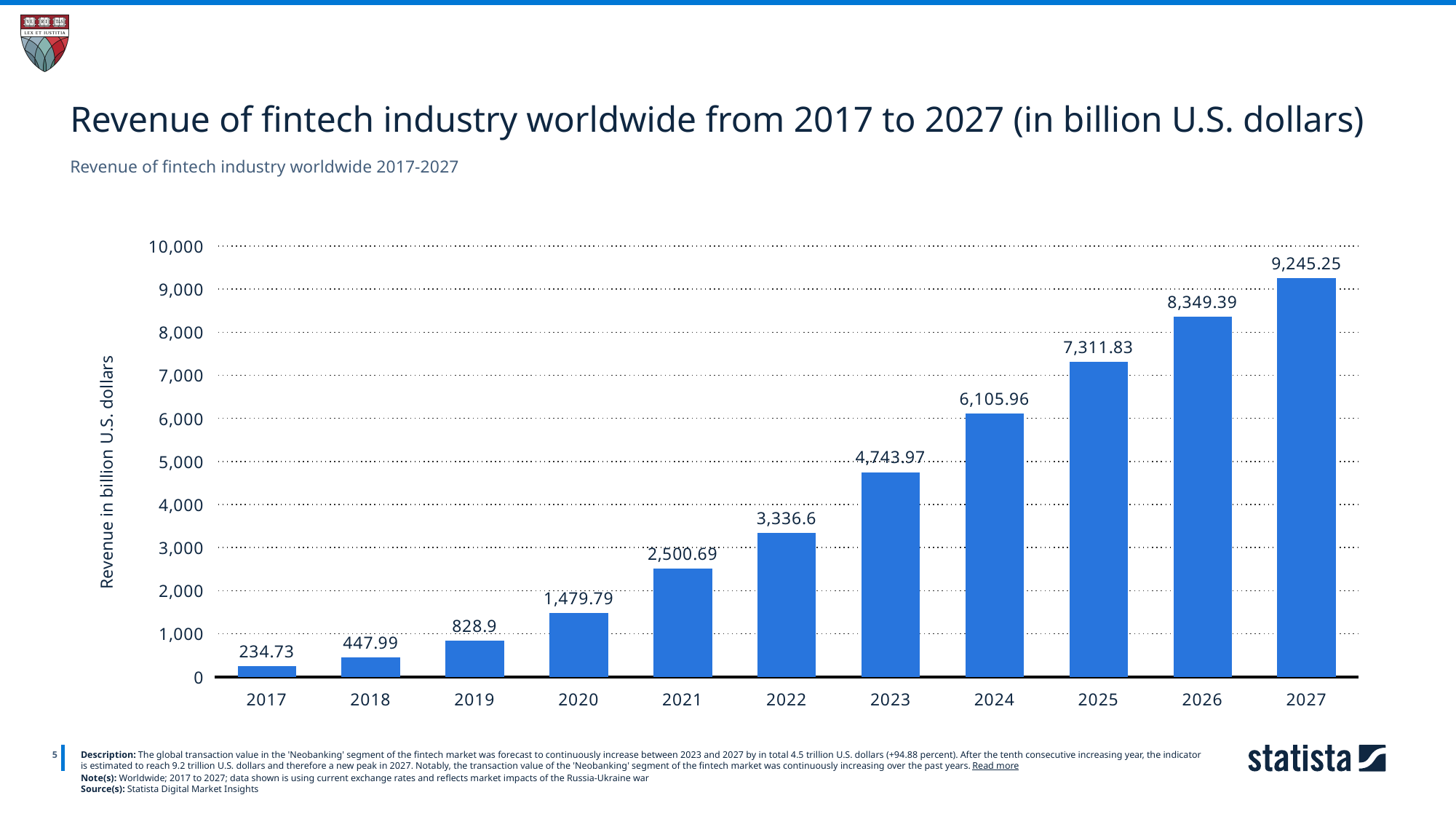
What is the revenue of the fintech industry worldwide in 2020? 1,479.79 Which is larger, the revenue in 2022 or the revenue in 2023? 2023 What is the difference between the revenue in 2018 and the revenue in 2017? 213.26 What is the revenue value shown for 2024? 6,105.96 How many years are shown on the x axis? 11 Is the value for 2025 greater or less than 7,000? greater What is the revenue value shown for 2017? 234.73 Which year has the highest revenue? 2027 What kind of chart is shown on the slide? bar chart Do the revenue values rise or fall from 2017 to 2027? rise Which year has the lowest revenue? 2017 What is the difference between the revenue in 2027 and the revenue in 2026? 895.86